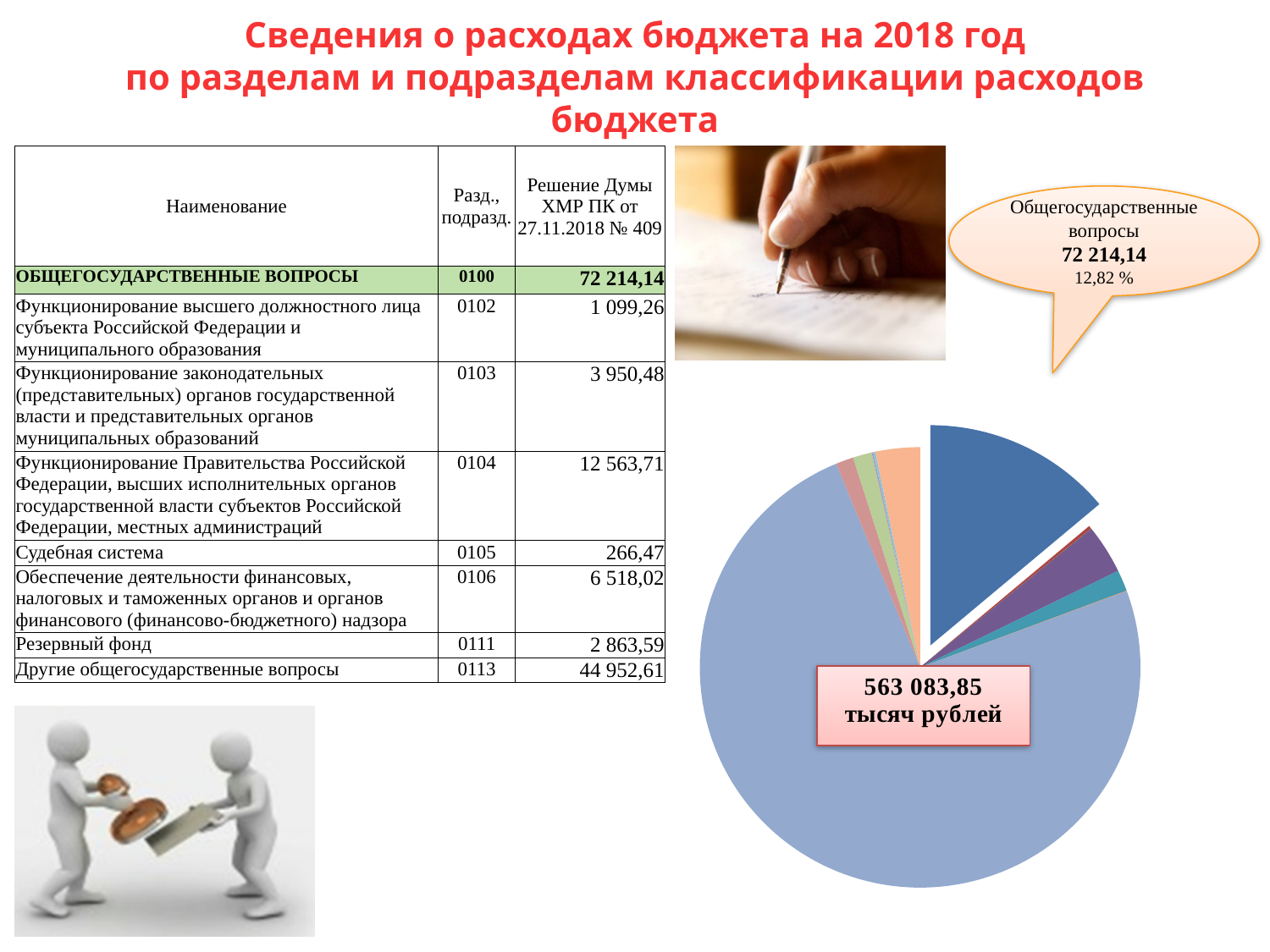
What kind of chart is shown on the right side of the slide? pie chart What total amount is printed in the centre of the pie chart? 563 083,85 тысяч рублей In the pie chart, what share of the total does the slice for Общегосударственные вопросы represent? 12,82 % Does the pie chart have a legend? no Is the share of Общегосударственные вопросы in the pie chart greater or less than 50%? less In the pie chart, what value is given for the slice Общегосударственные вопросы? 72 214,14 What colour is the pulled-out slice labelled Общегосударственные вопросы in the pie chart? dark blue Is the slice for Общегосударственные вопросы the largest slice of the pie chart? no